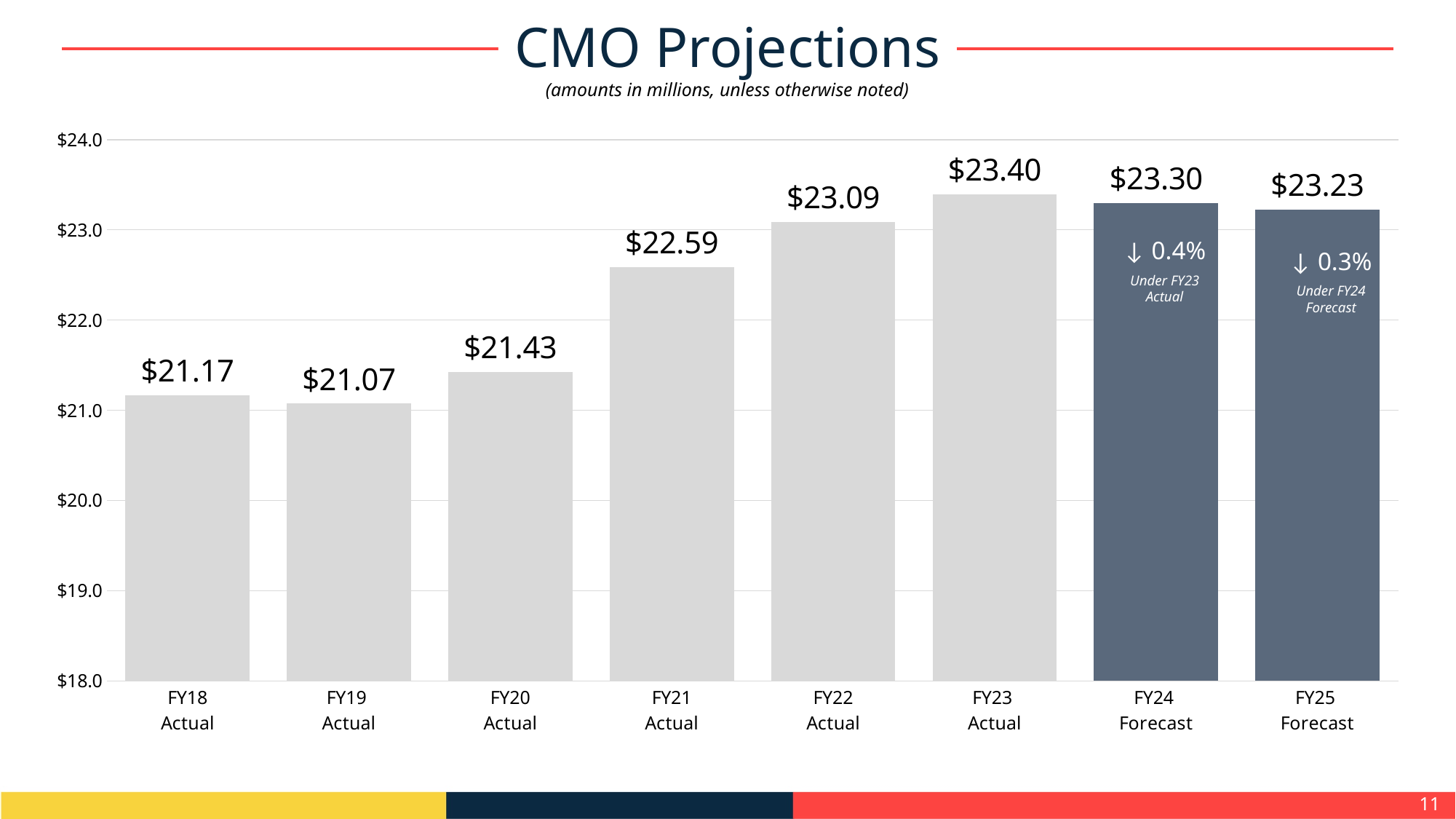
What is the value for FY18 Actual? $21.17 How many fiscal years are shown on the chart? 8 What kind of chart is shown on the slide? Bar chart Is the value for FY25 Forecast greater or less than $23.0? greater What is the difference between the FY22 Actual and FY21 Actual values? $0.50 Which fiscal year has the highest value? FY23 Actual What is the difference between the FY23 Actual and FY24 Forecast values? $0.10 What is the title of the chart? CMO Projections Which fiscal year has the lowest value? FY19 Actual Which is larger, the value for FY20 Actual or FY19 Actual? FY20 Actual What is the value for FY21 Actual? $22.59 What is the value for FY24 Forecast? $23.30